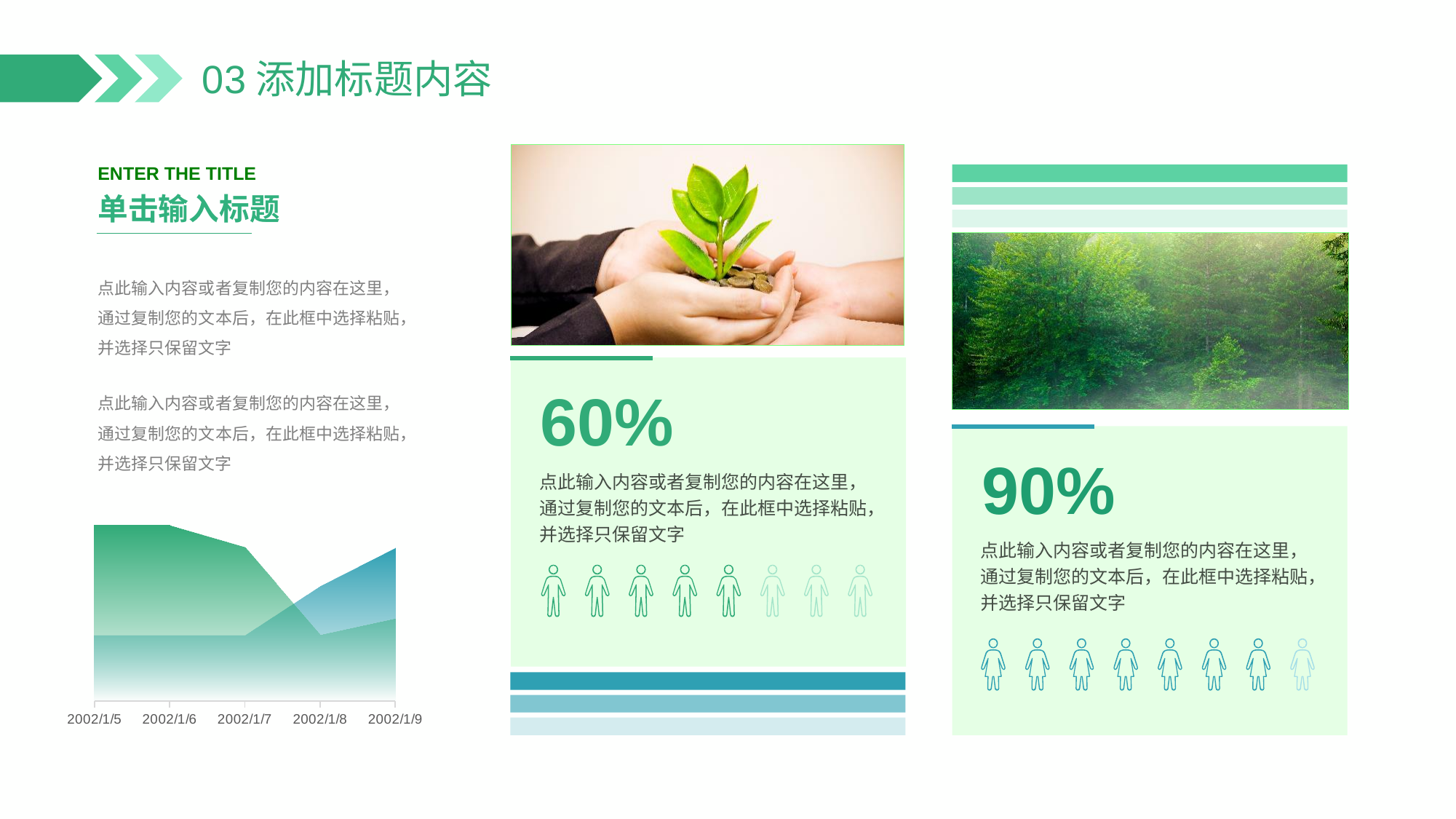
What is the last date label on the x axis of the area chart? 2002/1/9 In the area chart, at which date does the blue series reach its highest point? 2002/1/9 What kind of chart is shown at the bottom left of the slide? area chart In the area chart, which series is higher at 2002/1/5, the green or the blue? green How many dates are labelled on the x axis of the area chart? 5 What is the first date label on the x axis of the area chart? 2002/1/5 In the area chart, at which date does the green series reach its lowest point? 2002/1/8 In the area chart, does the blue series rise or fall from 2002/1/5 to 2002/1/9? rise In the area chart, which series is higher at 2002/1/9, the green or the blue? blue In the area chart, does the green series rise or fall from 2002/1/5 to 2002/1/9? fall